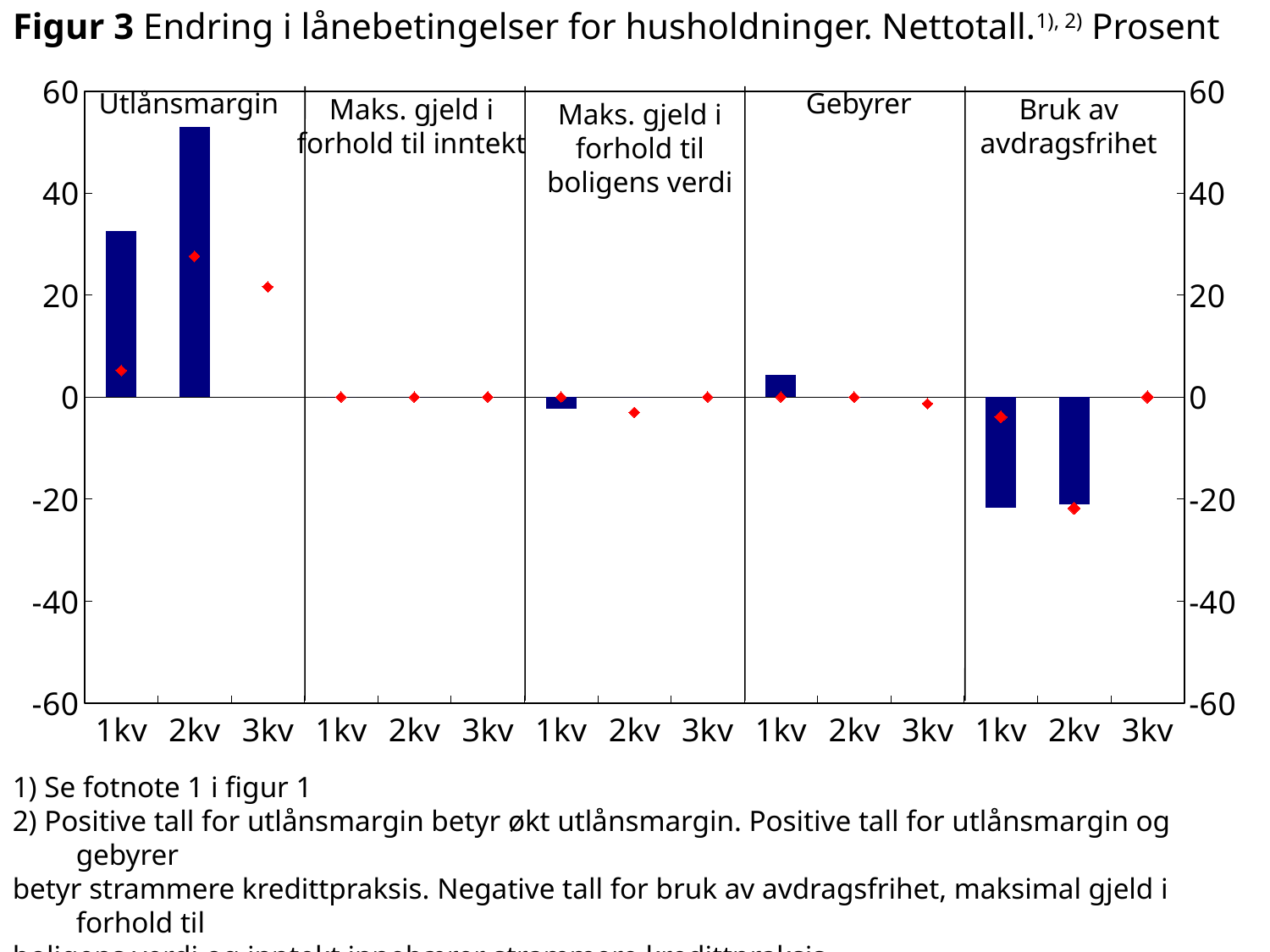
In the Utlånsmargin panel, which bar is larger, 1kv or 2kv? 2kv Is the bar for 1kv in the Bruk av avdragsfrihet panel greater or less than -10? less What kind of chart is shown in Figur 3? bar chart Is the bar for 2kv in the Utlånsmargin panel greater or less than 40? greater In the Utlånsmargin panel, do the bars rise or fall from 1kv to 2kv? rise How many quarters (kv) are shown in each panel? 3 What colour are the bars in the chart? dark blue Is the bar for 1kv in the Gebyrer panel greater or less than 20? less How many lending-condition panels does the chart have? 5 Which panel and quarter has the tallest bar in the chart? Utlånsmargin, 2kv Which panel has no bars at all, only markers at zero? Maks. gjeld i forhold til inntekt